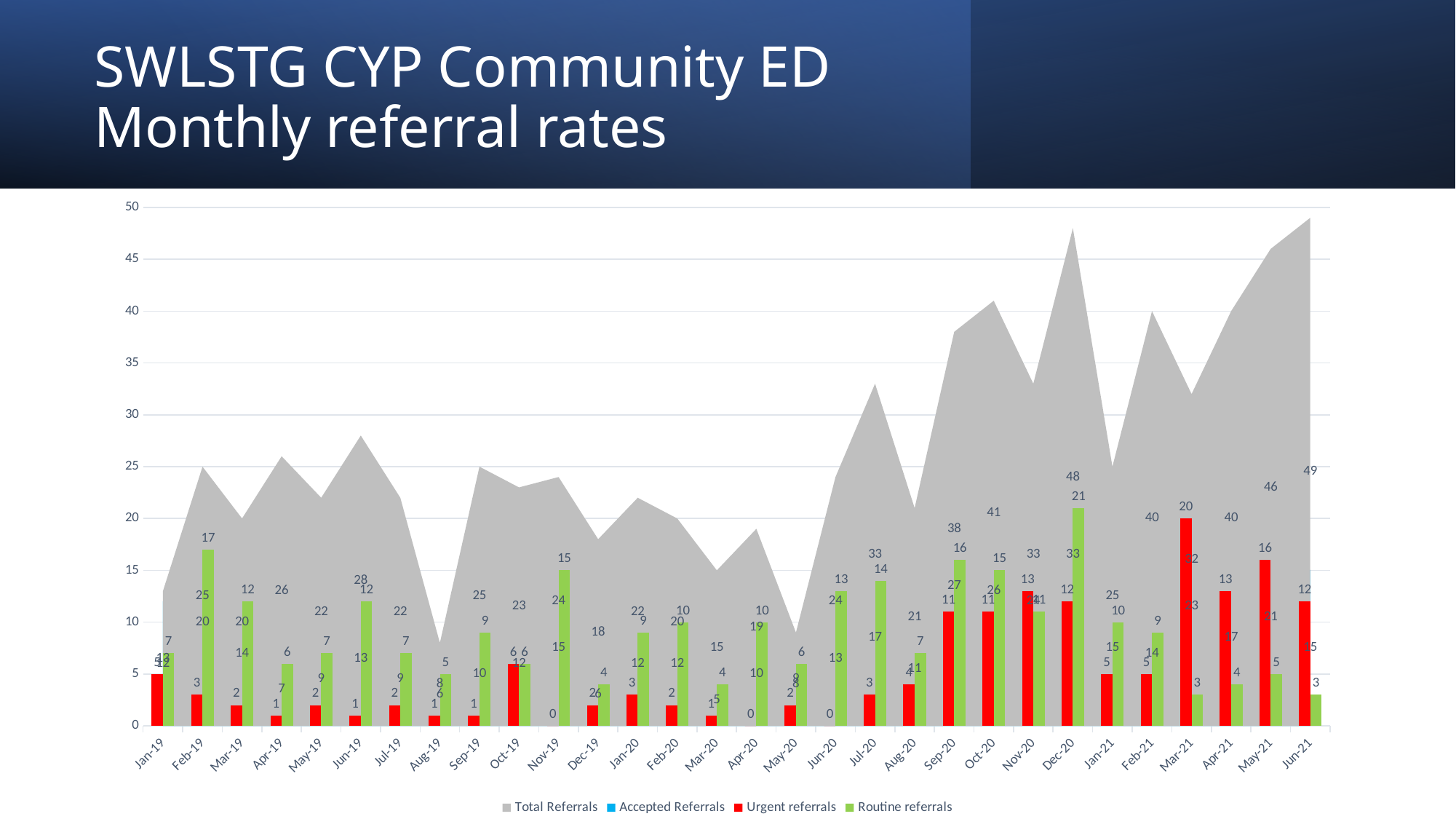
Do the Total Referrals values rise or fall from Mar-21 to Jun-21? rise What is the value of Total Referrals for Jun-21? 49 In Feb-19, which is larger: Urgent referrals or Routine referrals? Routine referrals What is the value of Routine referrals for Feb-19? 17 How many series does the legend list? 4 What is the value of Urgent referrals for Nov-19? 0 Is the Total Referrals value for Sep-20 greater or less than 35? greater How many months are shown on the x axis? 30 Which month has the highest Urgent referrals value? Mar-21 Which month has the highest Routine referrals value? Dec-20 What is the difference between Routine referrals and Urgent referrals in Dec-20? 9 What is the value of Urgent referrals for Mar-21? 20